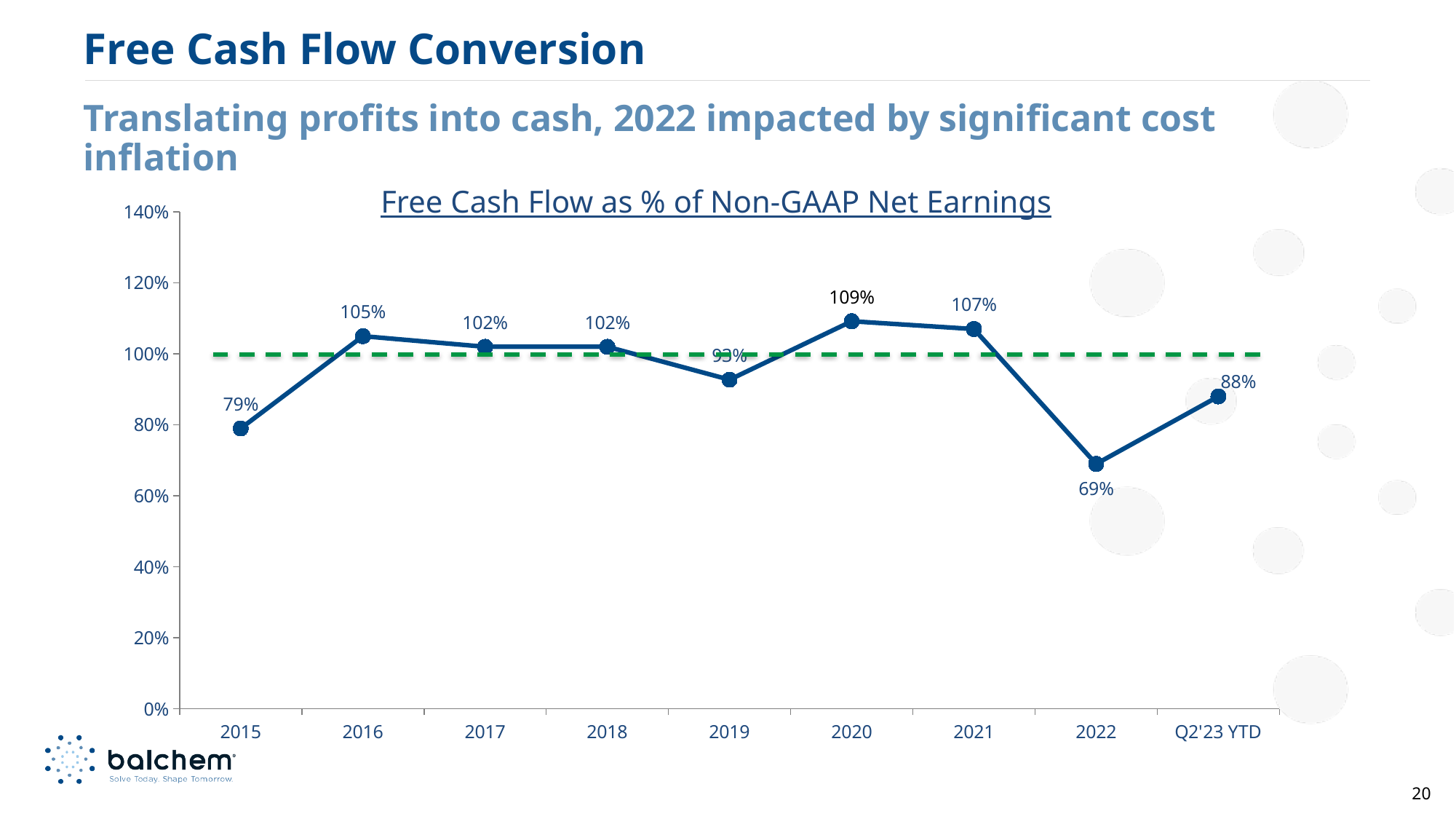
Is the value for 2019 greater or less than 100%? less Which year has the lowest free cash flow conversion? 2022 What is the title of the chart? Free Cash Flow as % of Non-GAAP Net Earnings What type of chart is shown on the slide? line chart How many data points are plotted on the chart? 9 What is the difference between the 2021 value and the 2022 value? 38% Which year has the highest free cash flow conversion? 2020 Which is larger, the value for 2016 or the value for 2021? 2021 What is the free cash flow conversion value for 2015? 79% What is the free cash flow conversion value for 2020? 109% Does the value rise or fall from 2021 to 2022? fall What is the free cash flow conversion value for Q2'23 YTD? 88%